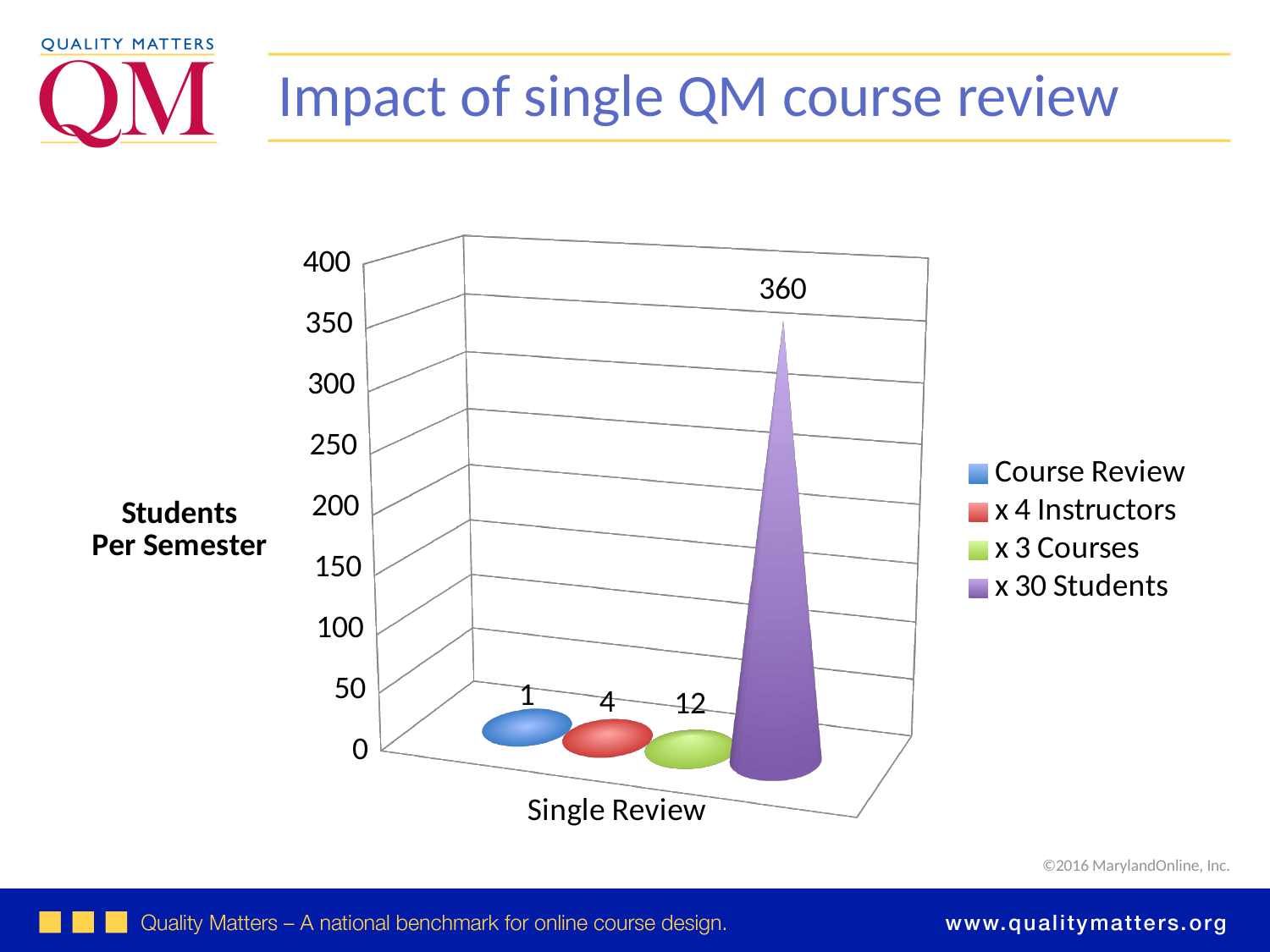
What is the value for the x 3 Courses series? 12 Which series has the highest value? x 30 Students What is the value for the x 30 Students series? 360 Is the value for x 30 Students greater or less than 350? greater What is the value for the Course Review series? 1 What is the category label shown on the x axis? Single Review What is the difference between the x 30 Students value and the x 3 Courses value? 348 What is the label on the vertical axis? Students Per Semester What is the value for the x 4 Instructors series? 4 Which series has the lowest value? Course Review How many series does the legend list? 4 Which is larger, the value for x 4 Instructors or the value for x 3 Courses? x 3 Courses